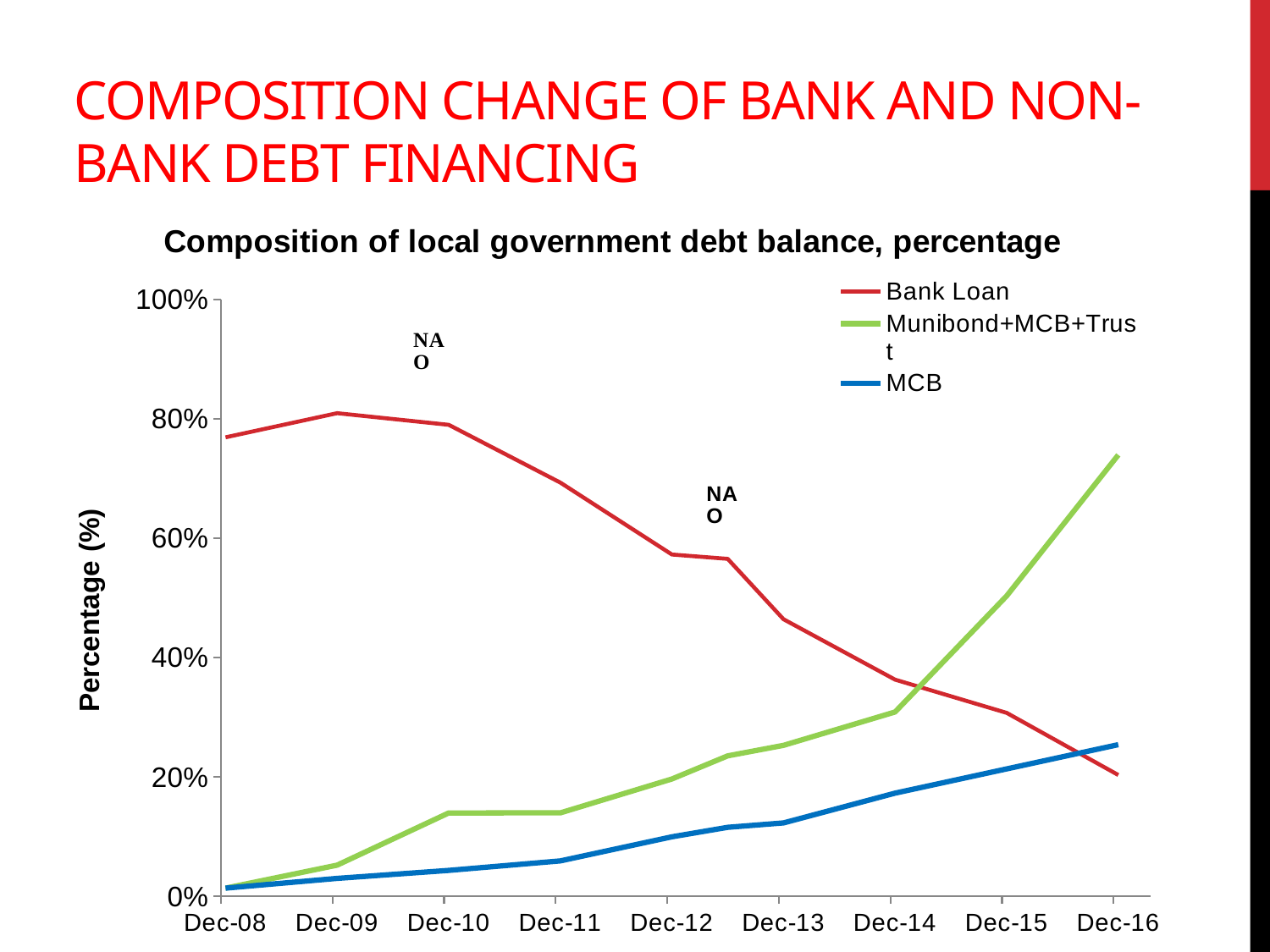
Which series has the highest value at Dec-08? Bank Loan Is the Bank Loan value at Dec-08 greater or less than 60%? greater Does the MCB series rise or fall overall from Dec-08 to Dec-16? rise Does the Bank Loan series rise or fall overall from Dec-08 to Dec-16? fall Which series has the highest value at Dec-16? Munibond+MCB+Trust What is the title of the chart? Composition of local government debt balance, percentage How many dates are labelled along the x axis? 9 Is the Munibond+MCB+Trust value at Dec-16 greater or less than 60%? greater Is the MCB value at Dec-16 greater or less than 40%? less What kind of chart is shown on the slide? line chart How many series does the legend list? 3 At Dec-12, which is larger: Bank Loan or Munibond+MCB+Trust? Bank Loan